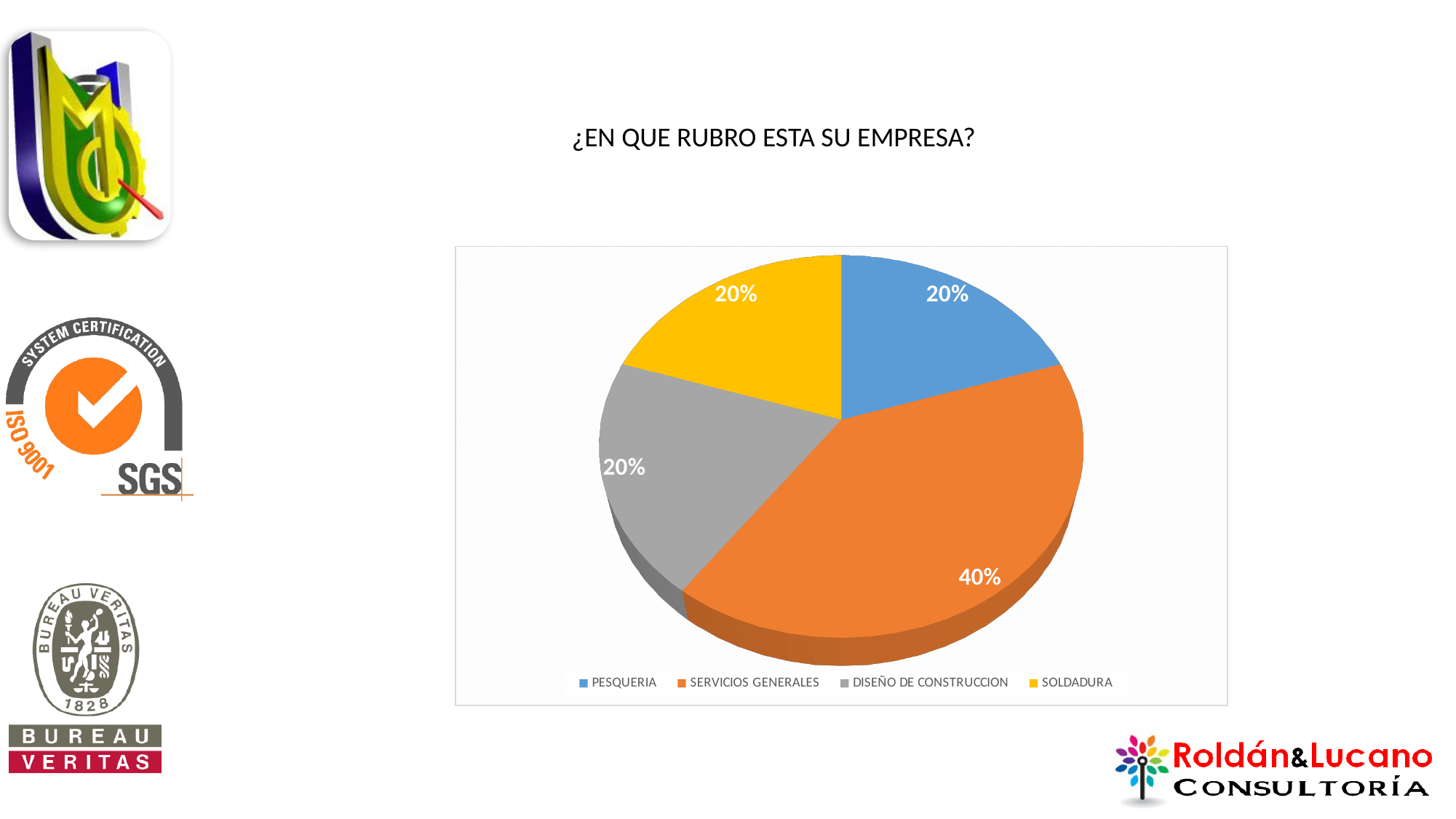
What is the difference between the shares of SERVICIOS GENERALES and PESQUERIA? 20% What share of the pie does PESQUERIA have? 20% What share of the pie does DISEÑO DE CONSTRUCCION have? 20% Which category has the largest slice of the pie? SERVICIOS GENERALES What is the title of the chart? ¿EN QUE RUBRO ESTA SU EMPRESA? What kind of chart is shown on the slide? pie chart How many categories does the pie chart show? 4 How many entries does the legend list? 4 What share of the pie does SOLDADURA have? 20% Which is larger, the share for SERVICIOS GENERALES or the share for SOLDADURA? SERVICIOS GENERALES What colour is the SOLDADURA slice? yellow